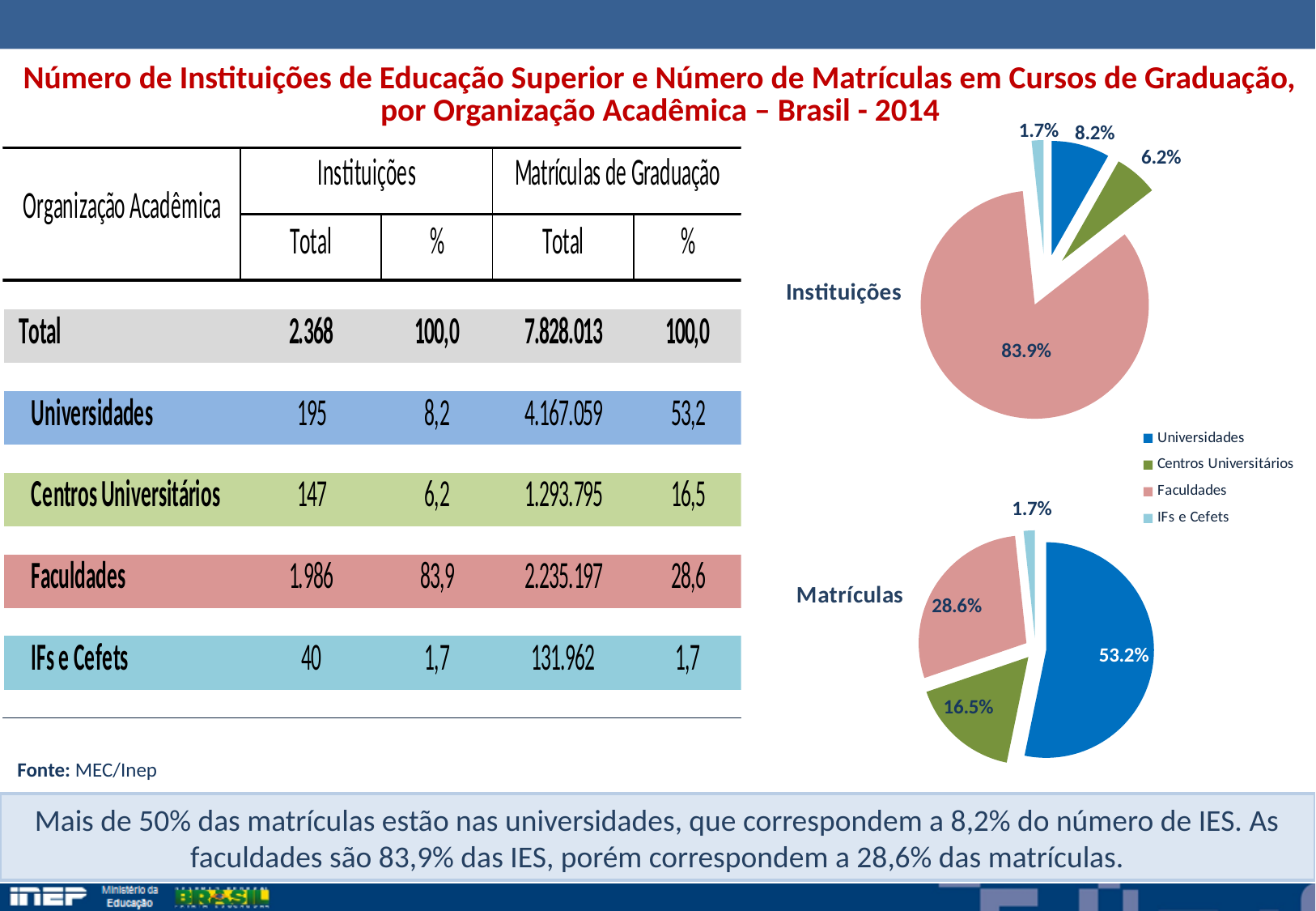
What kind of charts are shown on the slide? Pie charts In the Matrículas pie chart, what is the difference between the Universidades share and the Faculdades share? 24.6% In the Instituições pie chart, which category has the largest slice? Faculdades How many categories does the legend list for the pie charts? 4 In the Instituições pie chart, what share do Centros Universitários have? 6.2% In the Matrículas pie chart, which is larger: the Centros Universitários slice or the Faculdades slice? Faculdades In the Matrículas pie chart, what share do IFs e Cefets have? 1.7% In the Instituições pie chart, what share do Universidades have? 8.2% In the Matrículas pie chart, which category has the smallest slice? IFs e Cefets In the Matrículas pie chart, what share do Universidades have? 53.2% In the Matrículas pie chart, what share do Faculdades have? 28.6% In the Instituições pie chart, what share do Faculdades have? 83.9%